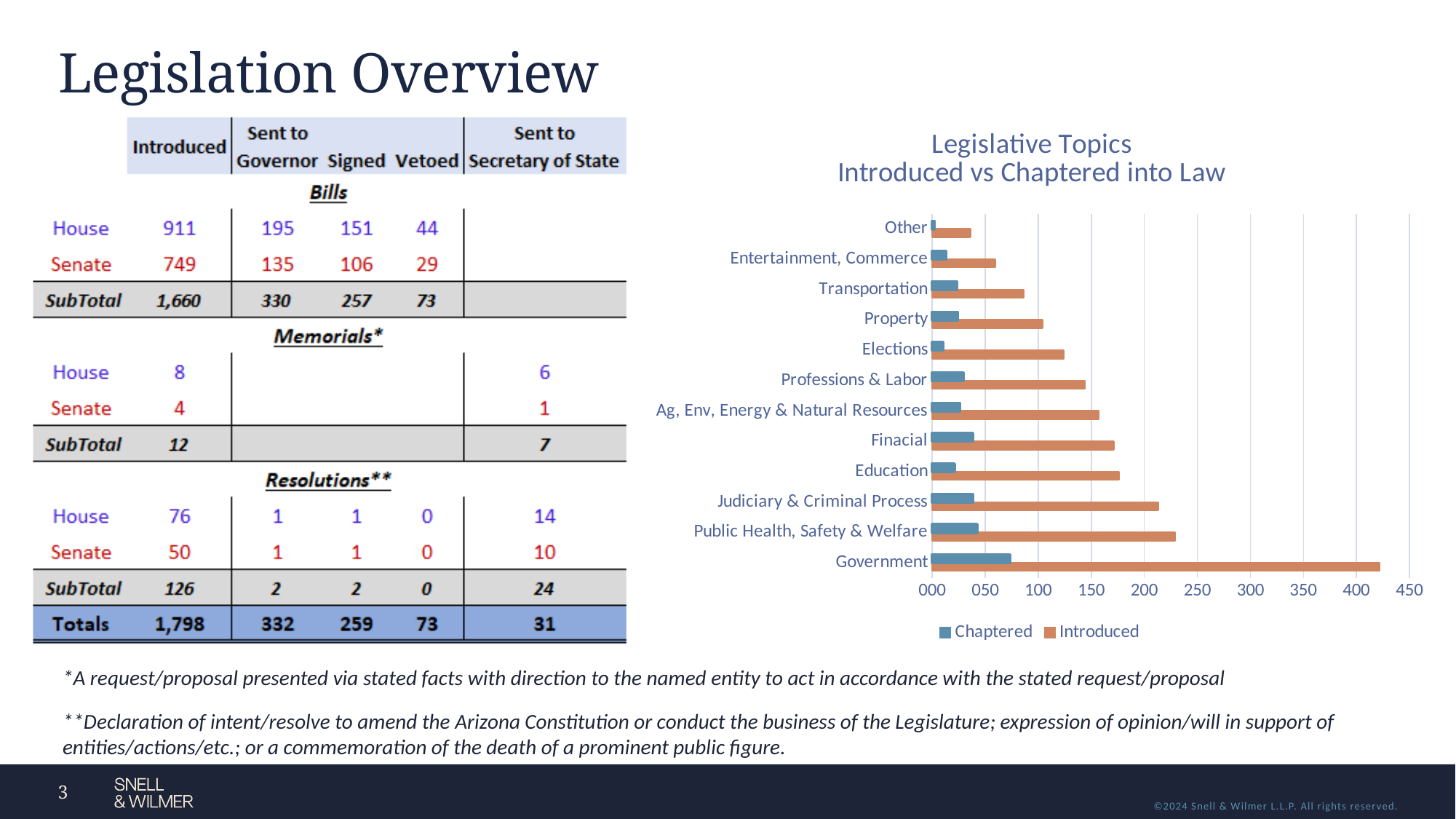
In the 'Legislative Topics' chart, is the Introduced value for Government greater or less than 400? greater In the 'Legislative Topics' chart, is the Chaptered value for Government greater or less than 50? greater In the 'Legislative Topics' chart, which topic has the lowest Introduced value? Other What kind of chart is the 'Legislative Topics Introduced vs Chaptered into Law' chart? bar chart What are the two legend entries of the 'Legislative Topics' chart? Chaptered and Introduced In the 'Legislative Topics' chart, which topic has the highest Introduced value? Government How many series does the legend of the 'Legislative Topics' chart list? 2 How many topic categories are shown on the 'Legislative Topics' chart? 12 In the 'Legislative Topics' chart, is the Introduced value for Other greater or less than 50? less In the 'Legislative Topics' chart, which topic has the highest Chaptered value? Government In the 'Legislative Topics' chart, which has the larger Introduced value: Public Health, Safety & Welfare or Education? Public Health, Safety & Welfare